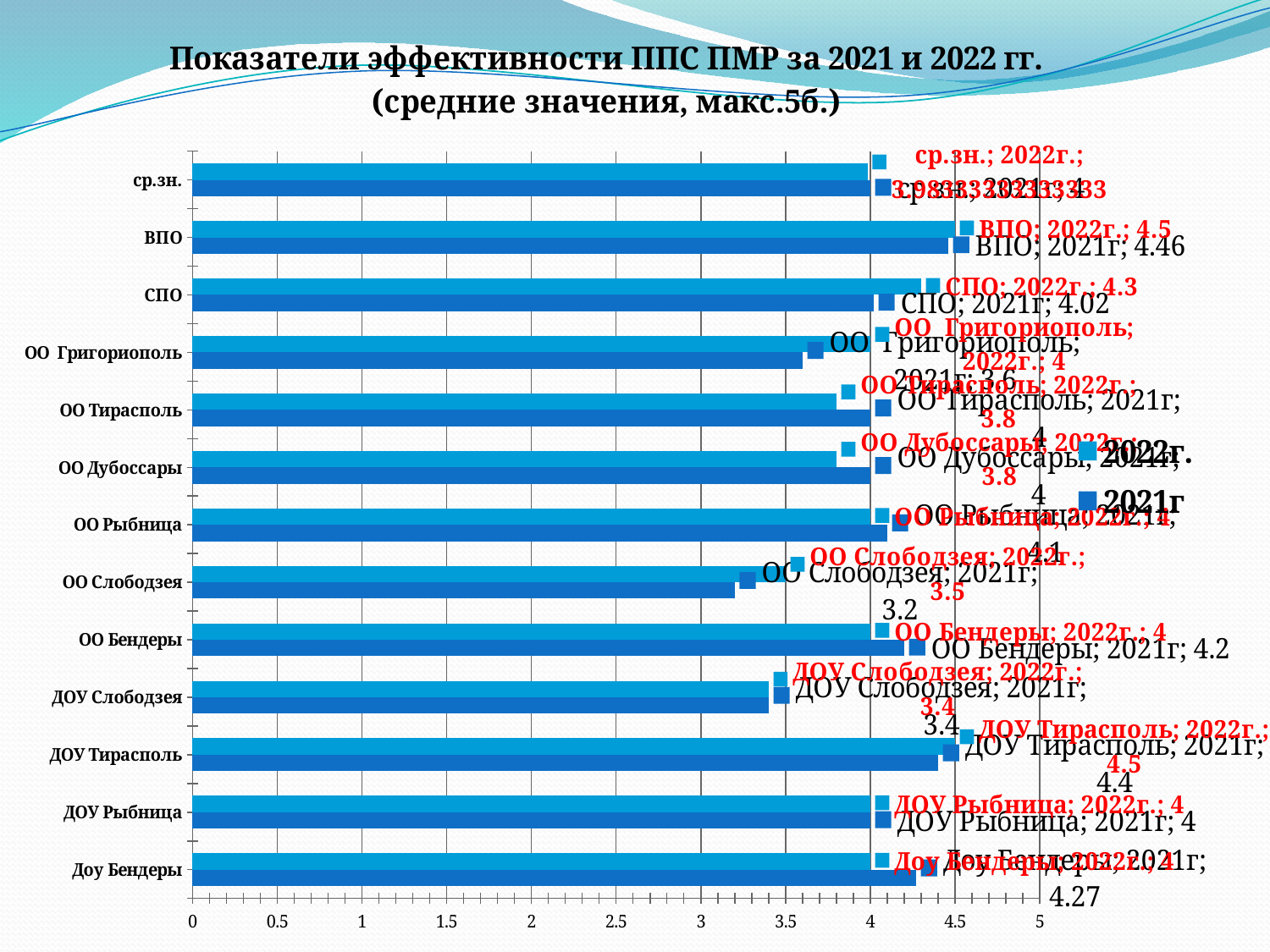
What is the value for ВПО in 2021г? 4.46 What is the value for Доу Бендеры in 2021г? 4.27 What is the value for СПО in 2022г.? 4.3 What is the difference between the 2022г. and 2021г values for ОО Григориополь? 0.4 What kind of chart is shown on the slide? bar chart What is the value for ОО Слободзея in 2021г? 3.2 How many series does the legend list? 2 For ОО Бендеры, which year has the larger value, 2021г or 2022г.? 2021г What are the two entries listed in the legend? 2022г. and 2021г Which category has the lowest value in the 2021г series? ОО Слободзея How many categories are plotted on the vertical axis? 13 Is the 2022г. value for ДОУ Слободзея greater or less than 4? less